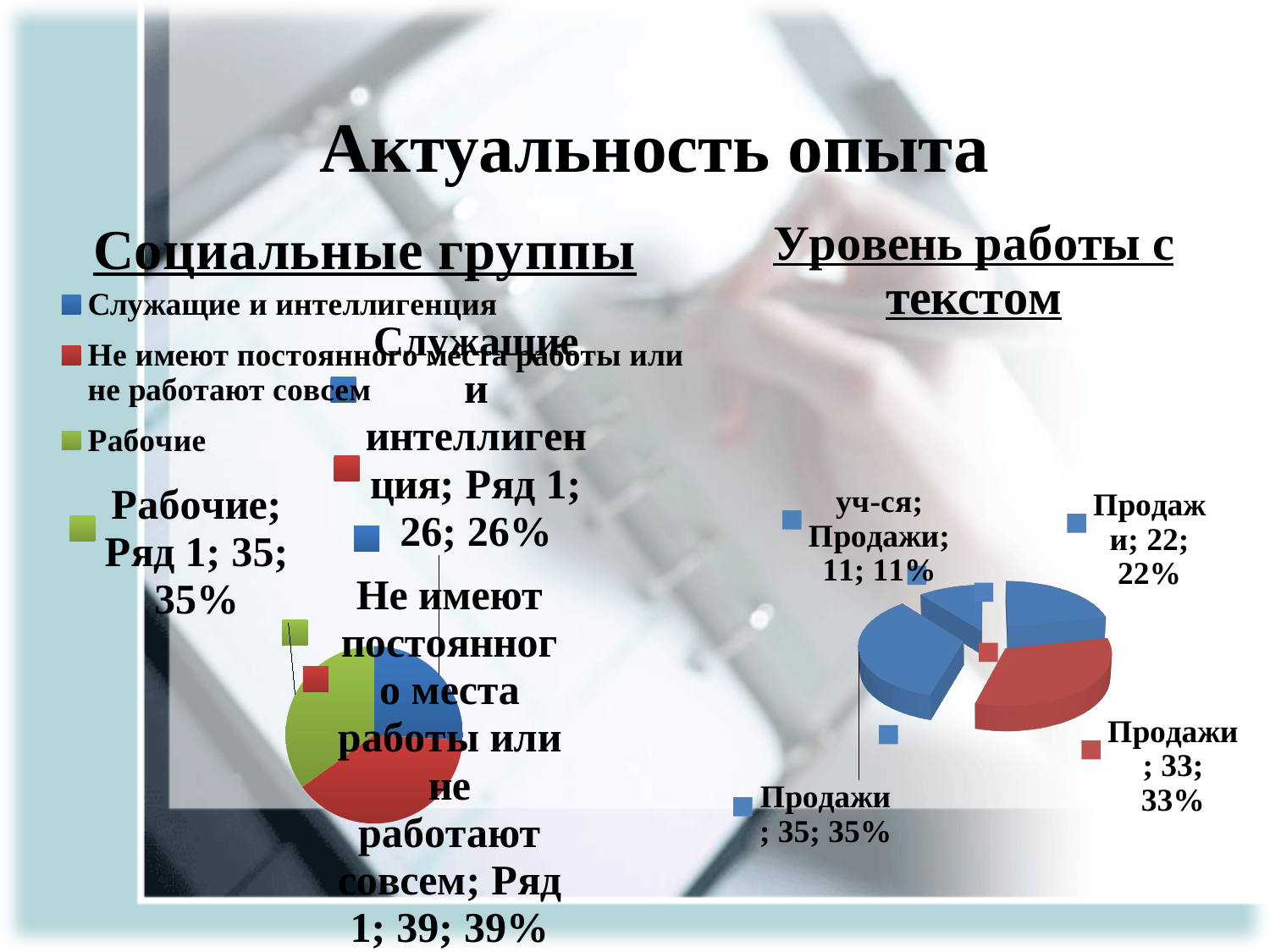
On the 'Социальные группы' chart, what percentage is shown for 'Рабочие'? 35% On the 'Уровень работы с текстом' chart, what percentage is shown for the slice labelled 'уч-ся'? 11% On the 'Социальные группы' chart, what kind of chart is shown? pie chart On the 'Социальные группы' chart, what percentage is shown for 'Не имеют постоянного места работы или не работают совсем'? 39% On the 'Уровень работы с текстом' chart, how many slices does the pie have? 4 On the 'Социальные группы' chart, what value is shown for 'Служащие и интеллигенция'? 26 On the 'Социальные группы' chart, what is the difference between the values for 'Рабочие' and 'Служащие и интеллигенция'? 9 On the 'Социальные группы' chart, how many categories does the legend list? 3 On the 'Социальные группы' chart, which category has the smallest slice? Служащие и интеллигенция On the 'Уровень работы с текстом' chart, what is the largest percentage shown on any slice? 35% On the 'Социальные группы' chart, which category has the largest slice? Не имеют постоянного места работы или не работают совсем On the 'Социальные группы' chart, what colour is the 'Рабочие' slice? green